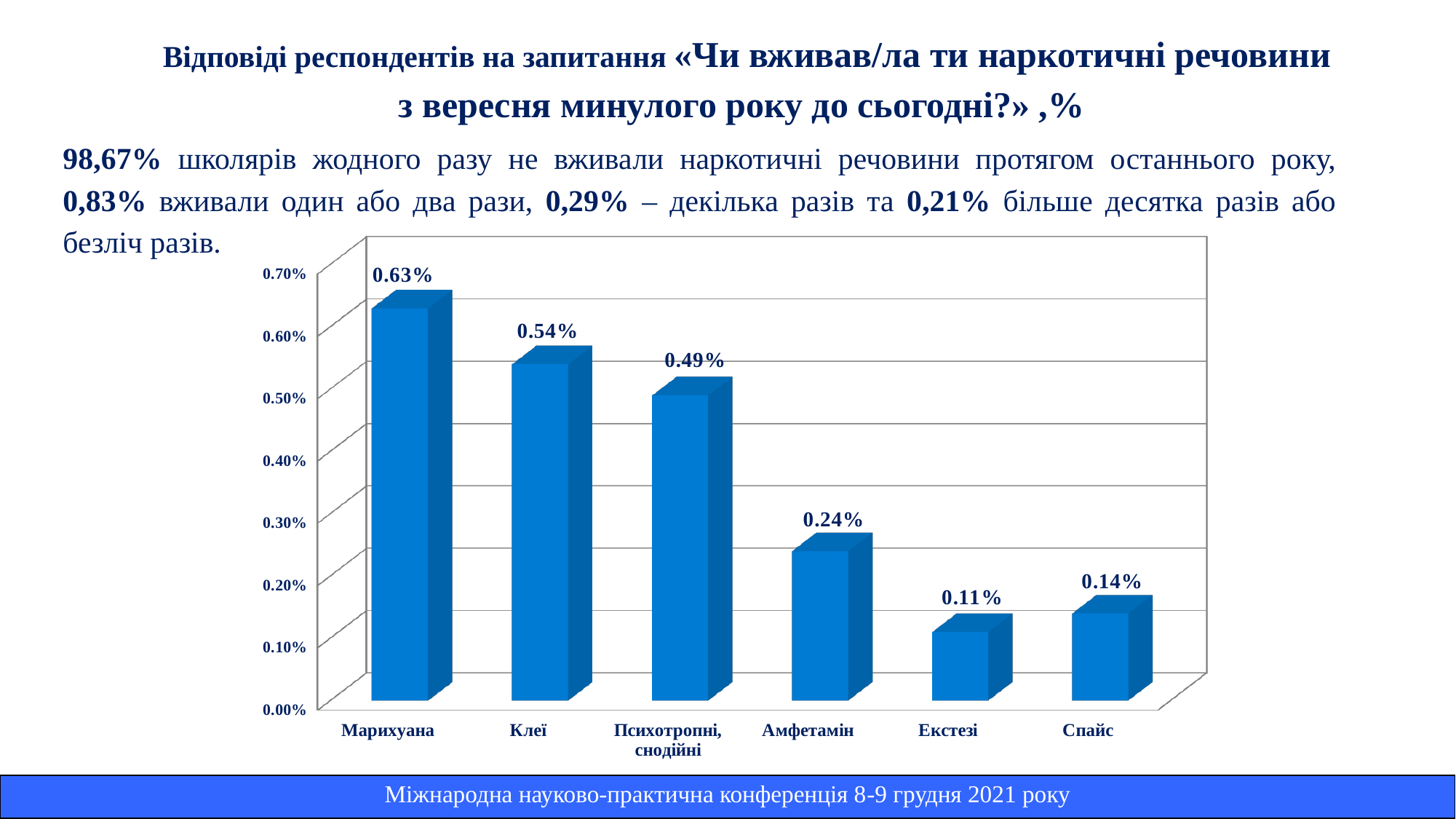
What is the value for Марихуана? 0.63% What is the difference between the values for Марихуана and Клеї? 0.09% What is the value of the highest tick on the vertical axis? 0.70% What is the value for Амфетамін? 0.24% Which is larger, the value for Спайс or the value for Екстезі? Спайс Which category has the highest value? Марихуана Which category has the lowest value? Екстезі What is the difference between the values for Психотропні, снодійні and Екстезі? 0.38% What kind of chart is shown on the slide? bar chart Is the value for Клеї greater or less than 0.50%? greater What is the value for Спайс? 0.14% How many categories are shown on the x axis? 6